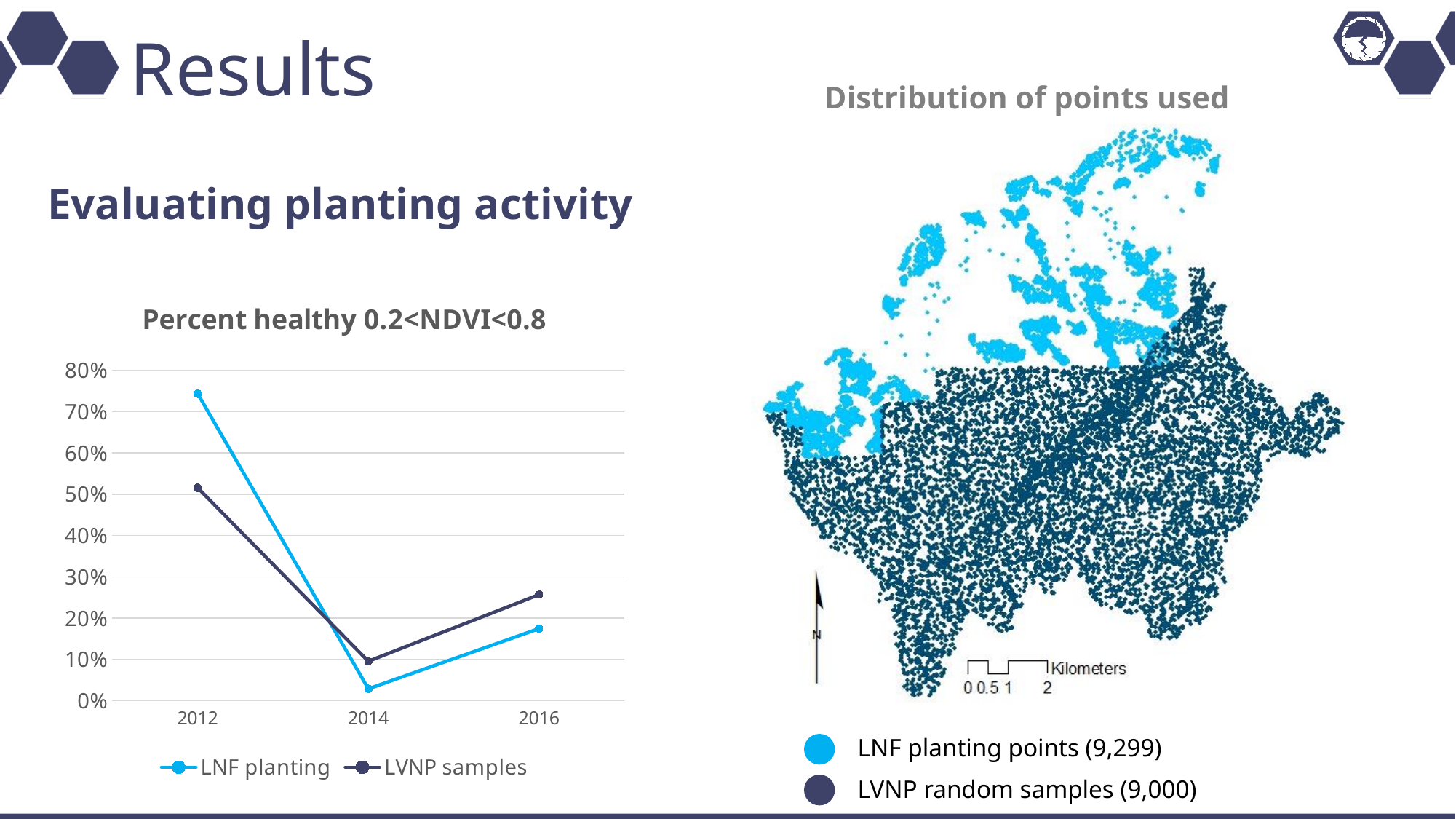
How many series does the legend of the "Percent healthy 0.2<NDVI<0.8" chart list? 2 In the "Percent healthy 0.2<NDVI<0.8" chart, is the LNF planting value for 2014 greater or less than 10%? less In the "Percent healthy 0.2<NDVI<0.8" chart, which series has the larger value in 2012, LNF planting or LVNP samples? LNF planting In the "Percent healthy 0.2<NDVI<0.8" chart, which year has the highest value for LNF planting? 2012 In the "Percent healthy 0.2<NDVI<0.8" chart, which series has the larger value in 2016, LNF planting or LVNP samples? LVNP samples In the "Percent healthy 0.2<NDVI<0.8" chart, is the LNF planting value for 2012 greater or less than 70%? greater What type of chart is "Percent healthy 0.2<NDVI<0.8"? line chart What is the title of the line chart on the left of the slide? Percent healthy 0.2<NDVI<0.8 In the "Percent healthy 0.2<NDVI<0.8" chart, does the LNF planting line rise or fall from 2012 to 2014? fall In the "Percent healthy 0.2<NDVI<0.8" chart, is the LVNP samples value for 2014 greater or less than 20%? less In the "Percent healthy 0.2<NDVI<0.8" chart, which year has the lowest value for LVNP samples? 2014 How many years are shown on the x axis of the "Percent healthy 0.2<NDVI<0.8" chart? 3